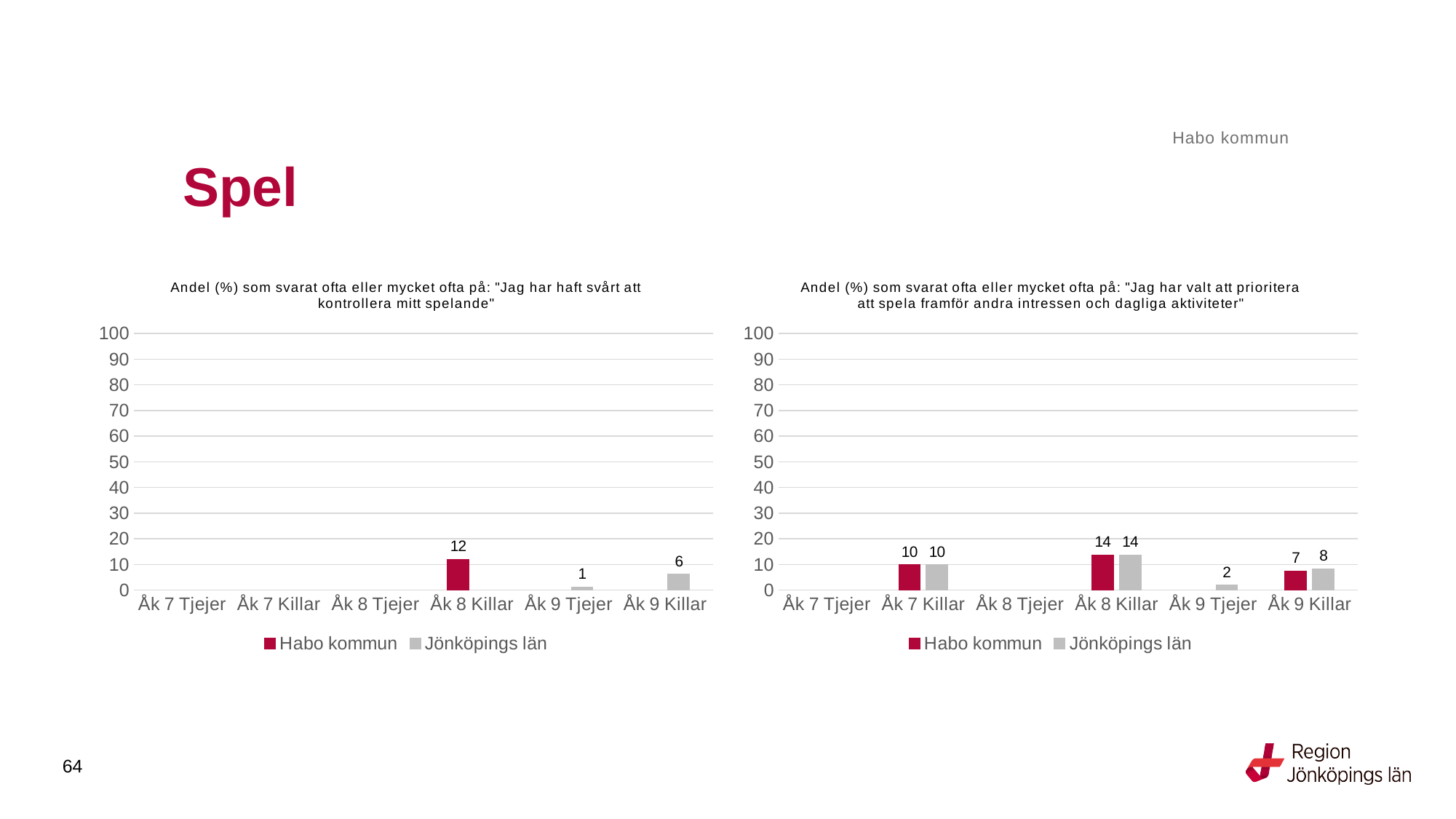
In the left chart, what is the value for Habo kommun for Åk 8 Killar? 12 How many categories are shown on the x axis of the right chart? 6 In the right chart, which is larger for Åk 9 Killar: Habo kommun or Jönköpings län? Jönköpings län In the right chart, what is the value for Jönköpings län for Åk 9 Killar? 8 How many series does the legend of the left chart list? 2 In the right chart, what is the value for Habo kommun for Åk 8 Killar? 14 What kind of chart is the left chart? Bar chart In the left chart, what is the value for Jönköpings län for Åk 9 Tjejer? 1 In the right chart, which category has the highest value for Habo kommun? Åk 8 Killar In the left chart, what is the value for Jönköpings län for Åk 9 Killar? 6 In the right chart, what is the difference between the Jönköpings län values for Åk 8 Killar and Åk 9 Killar? 6 In the right chart, what is the value for Habo kommun for Åk 7 Killar? 10